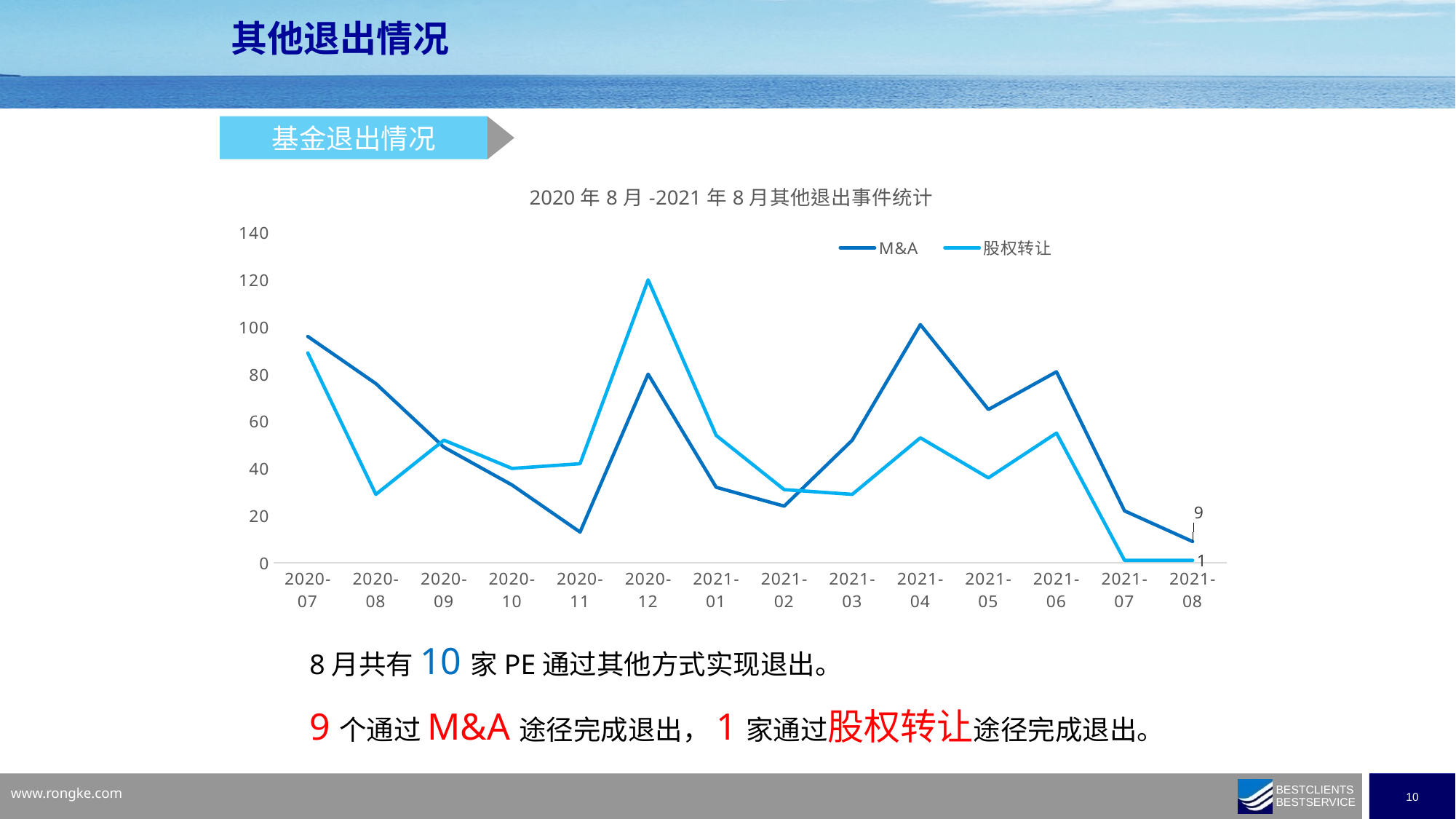
In which month does the 股权转让 series reach its highest value? 2020-12 Is the value for M&A at 2020-11 greater or less than 20? less How many months are plotted on the x axis? 14 What kind of chart is shown on the slide? line chart At 2021-08, which series has the larger value, M&A or 股权转让? M&A Is the value for M&A at 2021-04 greater or less than 80? greater What is the value for 股权转让 at 2021-08? 1 What is the value for M&A at 2021-08? 9 What is the difference between the M&A and 股权转让 values at 2021-08? 8 Does the M&A series rise or fall from 2021-06 to 2021-08? fall Is the value for 股权转让 at 2020-12 greater or less than 100? greater How many series does the legend list? 2